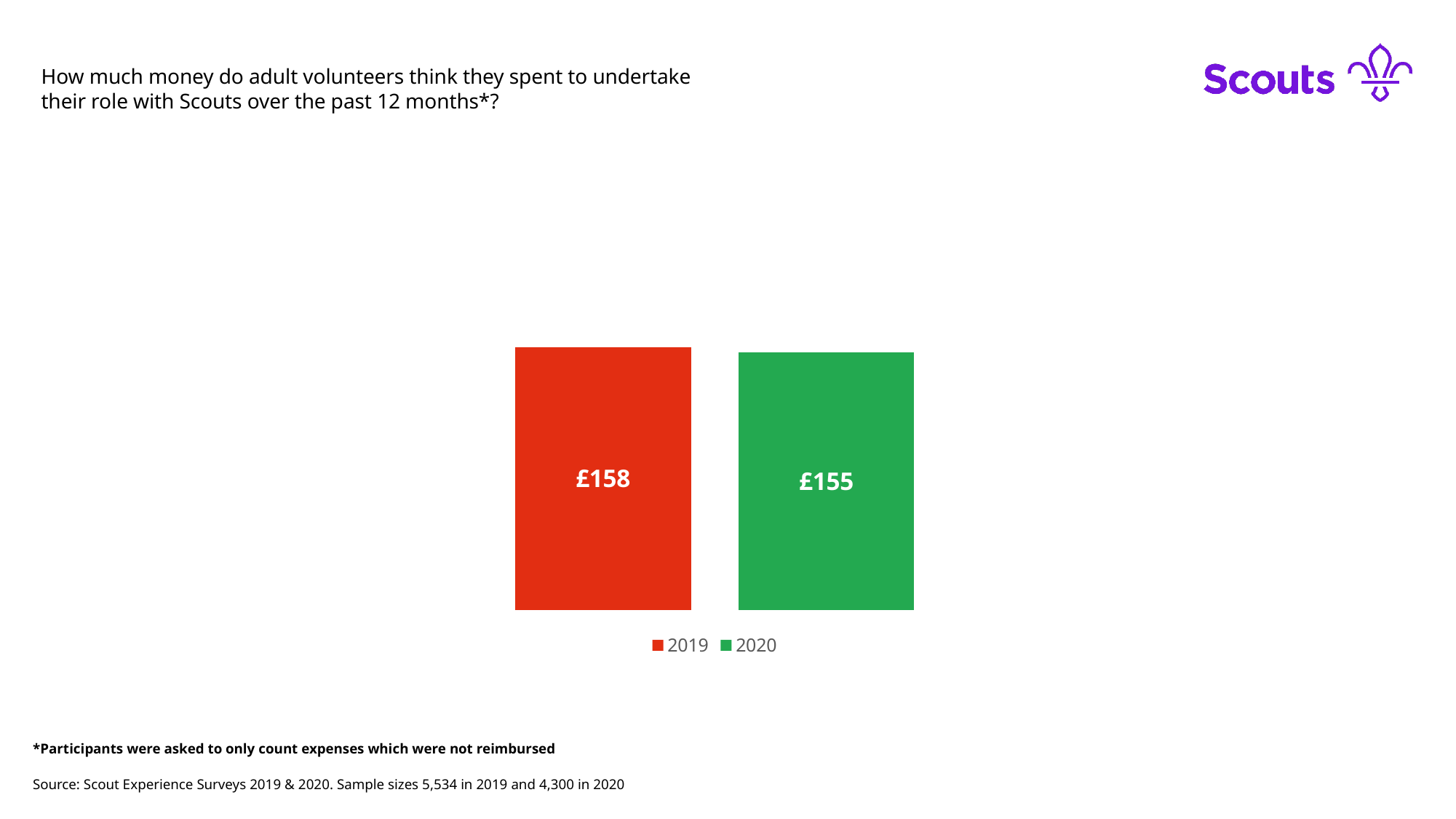
Which year is shown in red in the legend? 2019 What is the difference between the 2019 and 2020 values? £3 How many bars are plotted on the chart? 2 What is the value shown for 2019? £158 What kind of chart is shown on the slide? Bar chart How many series does the legend list? 2 What is the value shown for 2020? £155 Which year has the lowest value? 2020 Do the values rise or fall from 2019 to 2020? Fall What colour is the bar for 2020? Green Which year has the higher value, 2019 or 2020? 2019